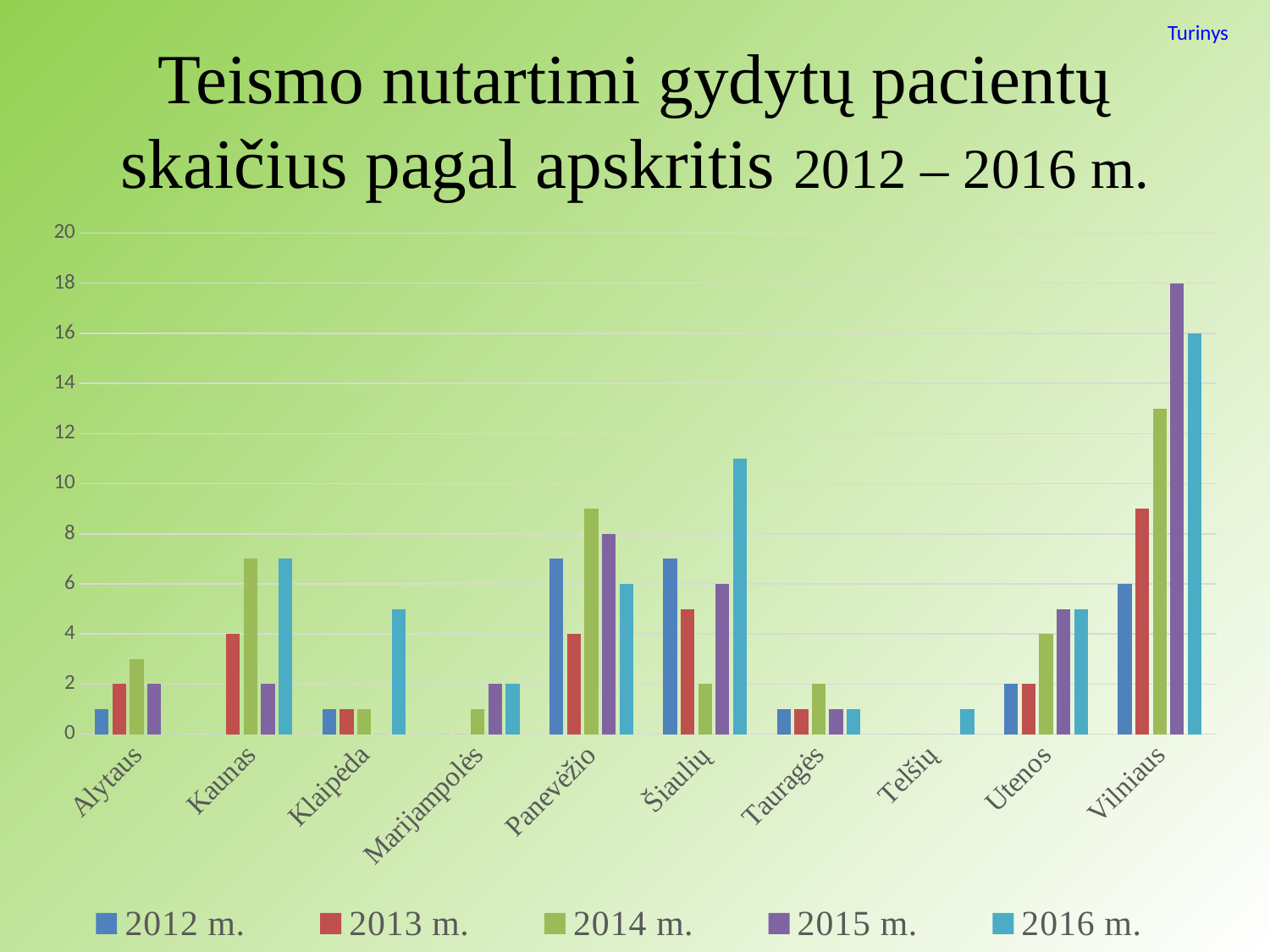
What is the value for Vilniaus in 2016 m.? 16 How many series does the legend list? 5 What kind of chart is shown on the slide? bar chart Is the value for Vilniaus in 2014 m. greater or less than 12? greater Which county and year has the tallest bar in the chart? Vilniaus, 2015 m. Which is larger for Vilniaus: the 2015 m. value or the 2016 m. value? 2015 m. What is the value for Panevėžio in 2015 m.? 8 How many counties (categories) are shown on the x axis? 10 What is the value for Vilniaus in 2015 m.? 18 What is the difference between the Vilniaus values for 2015 m. and 2016 m.? 2 Which county has a bar for only one year (2016 m.)? Telšių Is the value for Šiaulių in 2016 m. greater or less than 10? greater